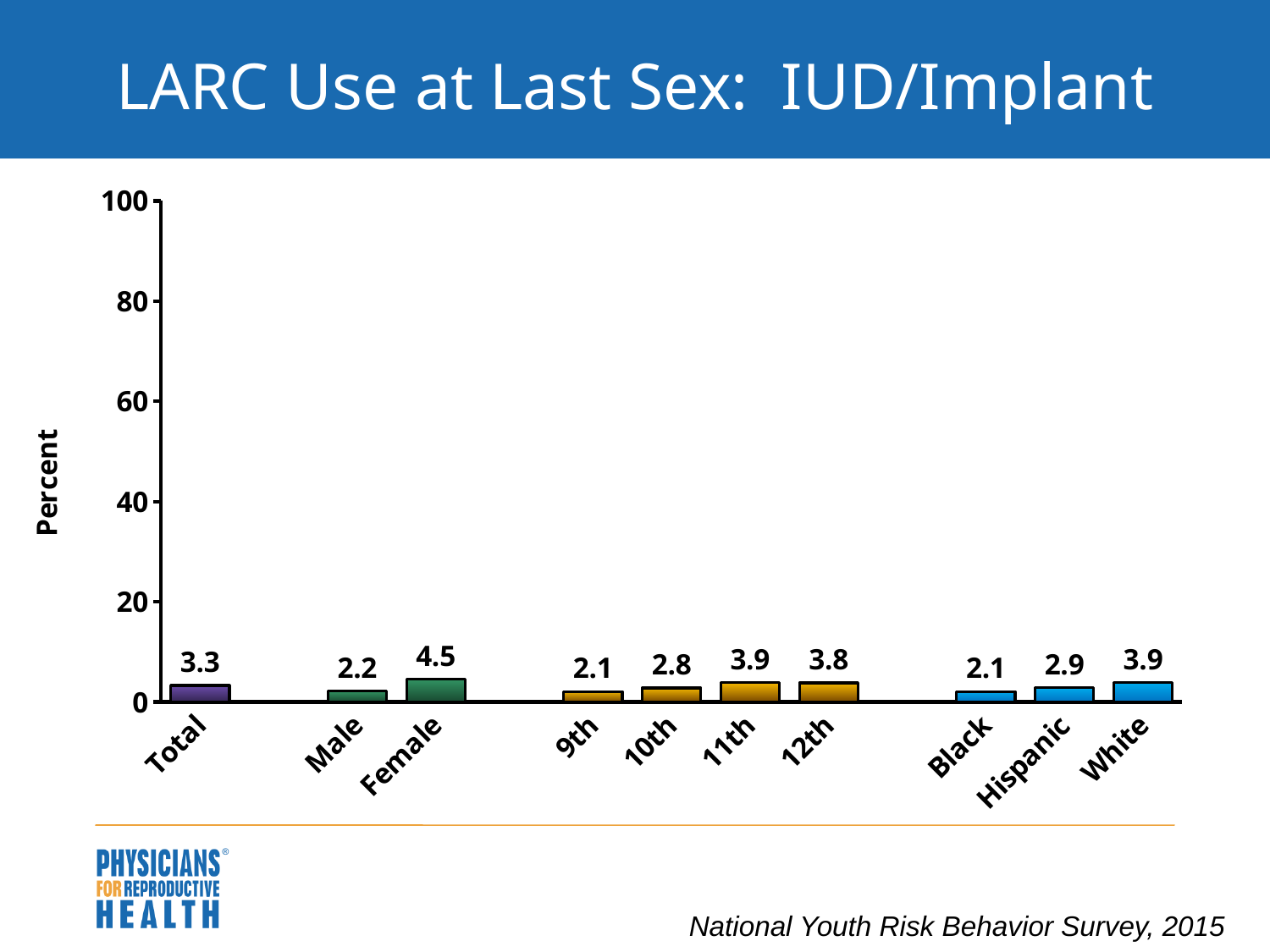
How many categories are shown on the x axis? 10 Which category has the highest value? Female What is the value for Total? 3.3 Which is larger, the value for 11th or the value for 9th? 11th Is the value for White greater or less than 20? less What kind of chart is shown? bar chart What is the value for Hispanic? 2.9 What is the value for Female? 4.5 What is the title of the chart? LARC Use at Last Sex: IUD/Implant What is the value for 10th? 2.8 What is the label of the y axis? Percent What is the difference between the values for Female and Male? 2.3